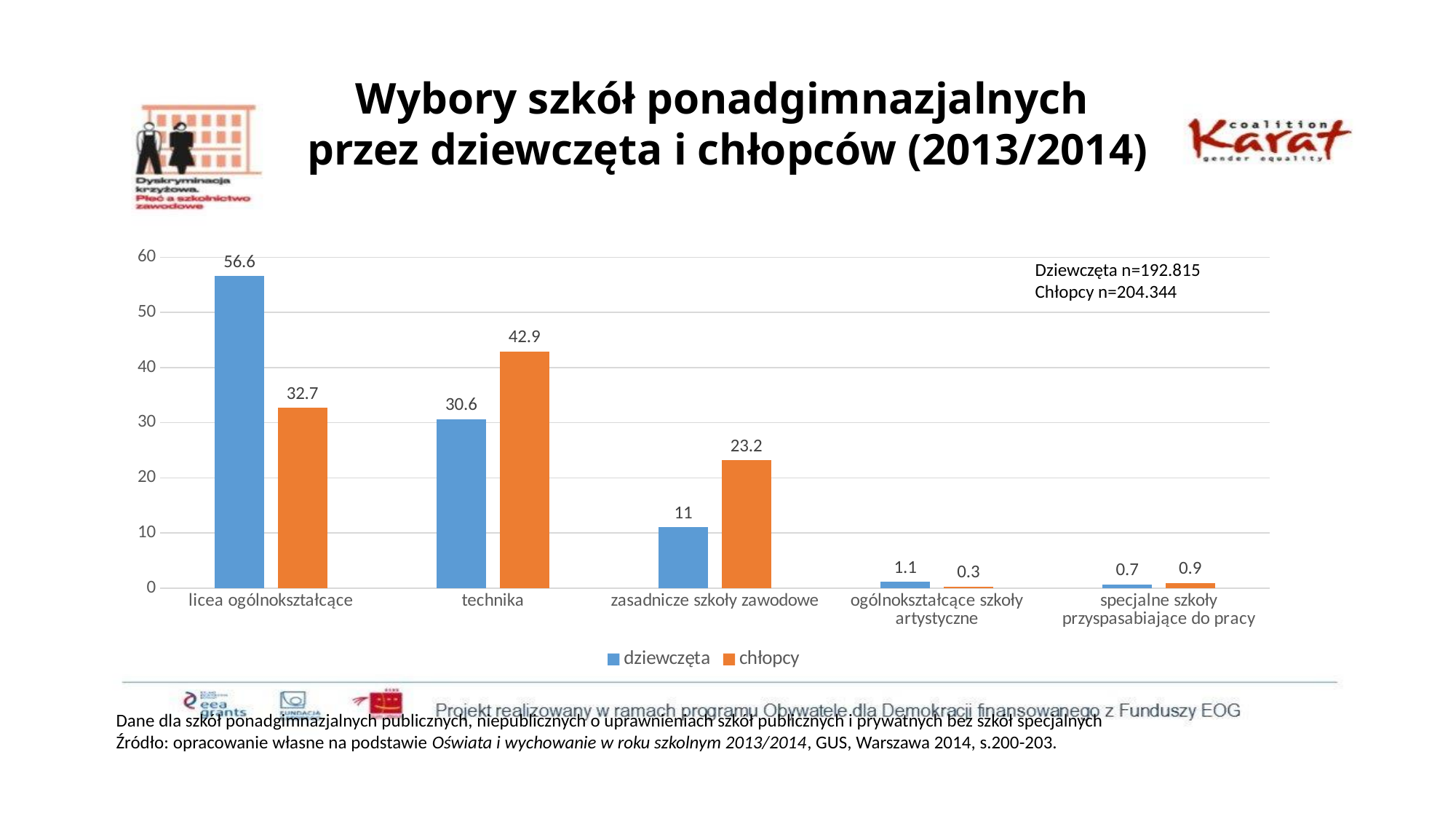
What is the value for dziewczęta in the licea ogólnokształcące category? 56.6 How many series does the legend list? 2 What kind of chart is shown on the slide? bar chart In the technika category, which series has the larger value, dziewczęta or chłopcy? chłopcy What is the difference between the dziewczęta and chłopcy values in the licea ogólnokształcące category? 23.9 What is the value for dziewczęta in the ogólnokształcące szkoły artystyczne category? 1.1 How many categories are shown on the x axis? 5 Which colour represents the chłopcy series? orange Which category has the lowest value for chłopcy? ogólnokształcące szkoły artystyczne What is the value for chłopcy in the zasadnicze szkoły zawodowe category? 23.2 What is the value for chłopcy in the technika category? 42.9 Which category has the highest value for dziewczęta? licea ogólnokształcące